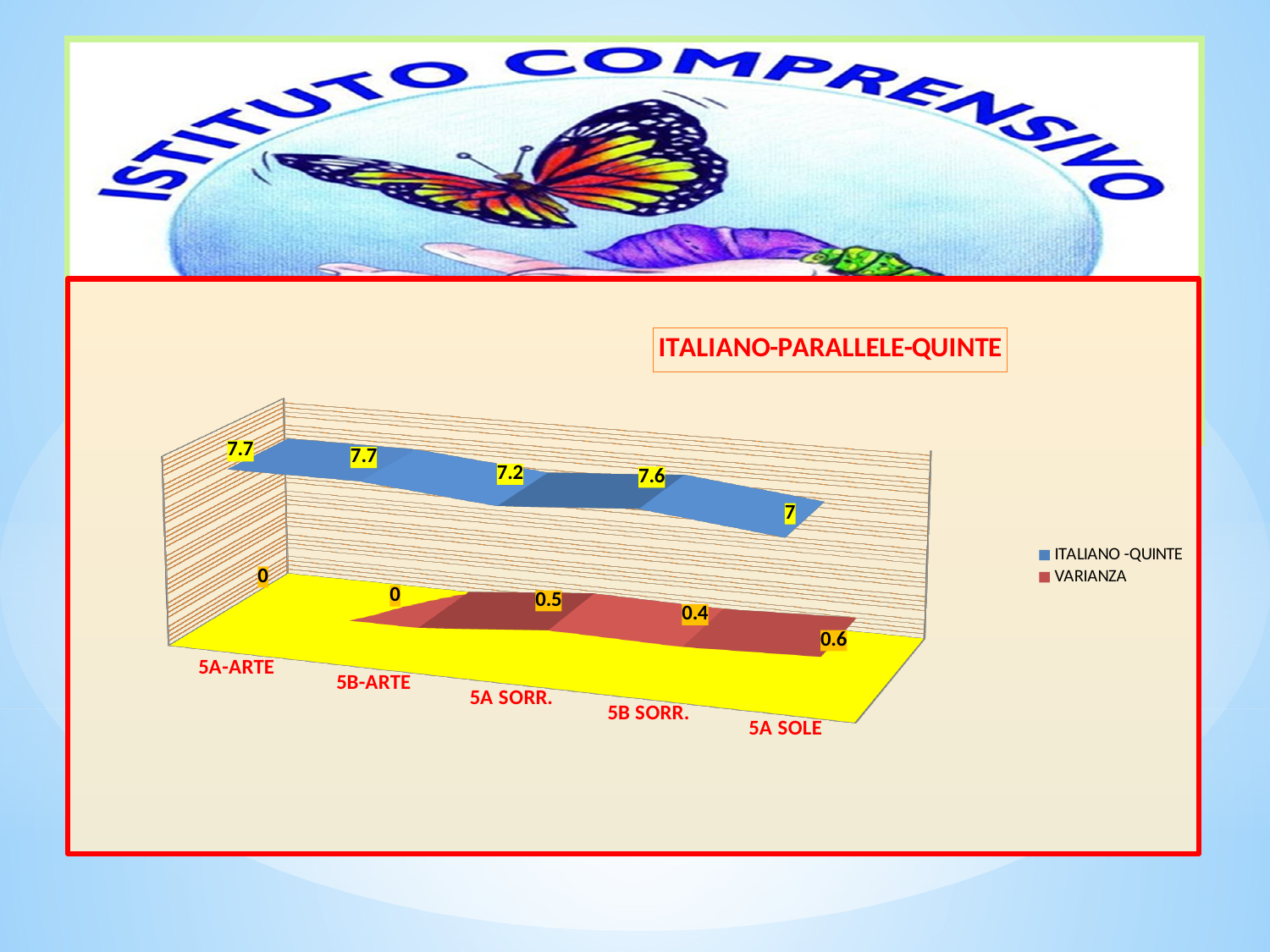
What kind of chart is shown on the slide? 3D line chart What is the VARIANZA value for 5B ARTE? 0 How many series does the legend list? 2 How many categories are shown on the x axis? 5 Which is larger, the VARIANZA value for 5A SORR. or for 5B SORR.? 5A SORR. Which category has the lowest ITALIANO -QUINTE value? 5A SOLE What is the VARIANZA value for 5A SOLE? 0.6 What is the difference between the ITALIANO -QUINTE values for 5A-ARTE and 5A SOLE? 0.7 What is the title of the chart? ITALIANO-PARALLELE-QUINTE What is the ITALIANO -QUINTE value for 5B SORR.? 7.6 Which category has the highest VARIANZA value? 5A SOLE What is the value of ITALIANO -QUINTE for 5A SORR.? 7.2